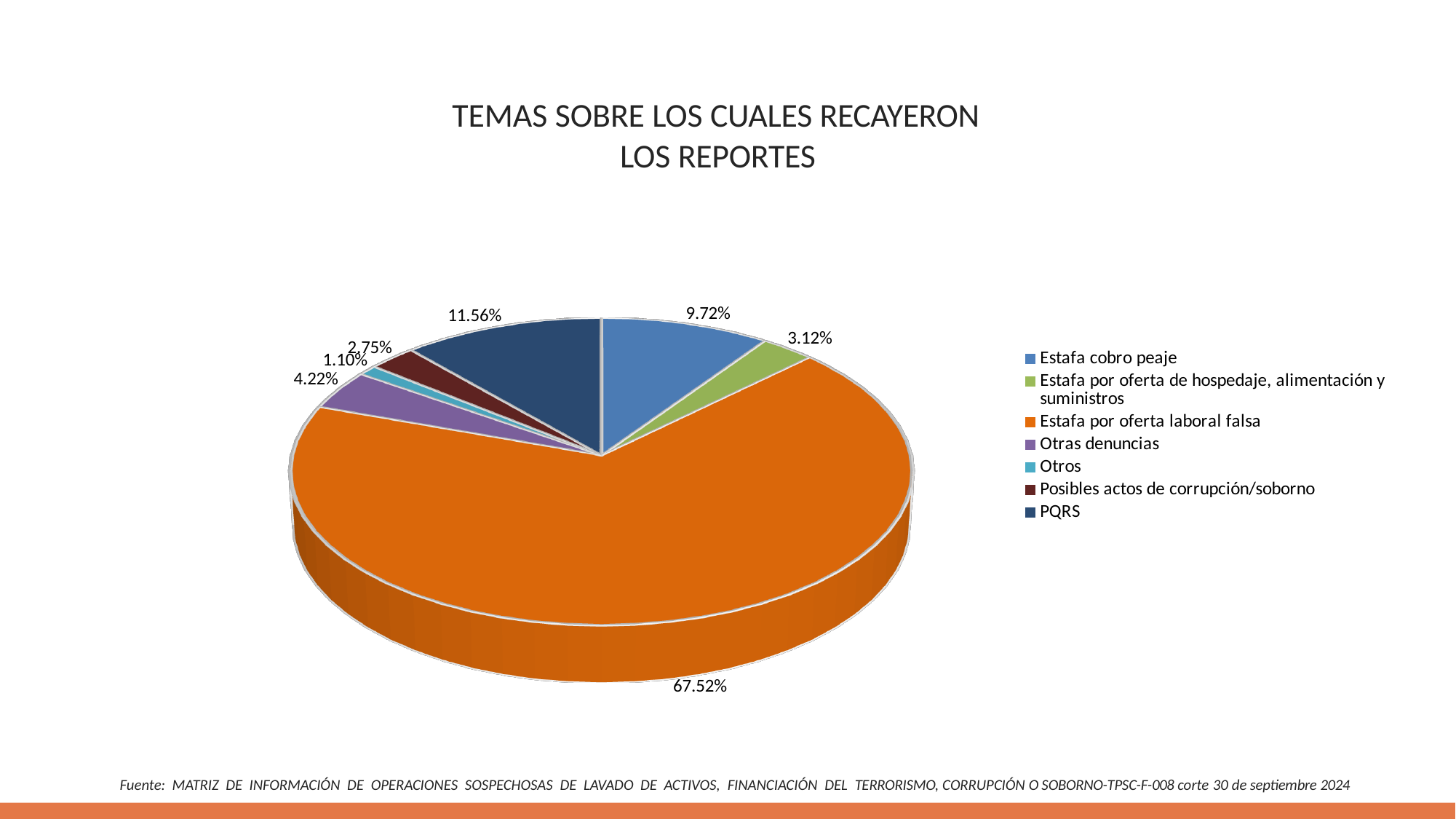
Which has a larger share: 'PQRS' or 'Estafa cobro peaje'? PQRS Which category has the smallest share of the reports? Otros What is the difference in percentage points between 'Otras denuncias' and 'Estafa por oferta de hospedaje, alimentación y suministros'? 1.10 percentage points What percentage of the reports corresponds to 'Posibles actos de corrupción/soborno'? 2.75% Which category has the largest share of the reports? Estafa por oferta laboral falsa What percentage of the reports corresponds to 'Otros'? 1.10% What percentage of the reports corresponds to 'Estafa cobro peaje'? 9.72% What is the title of the chart? TEMAS SOBRE LOS CUALES RECAYERON LOS REPORTES How many categories does the legend list? 7 What kind of chart is shown on the slide? Pie chart What percentage of the reports corresponds to 'PQRS'? 11.56% What percentage of the reports corresponds to 'Estafa por oferta laboral falsa'? 67.52%